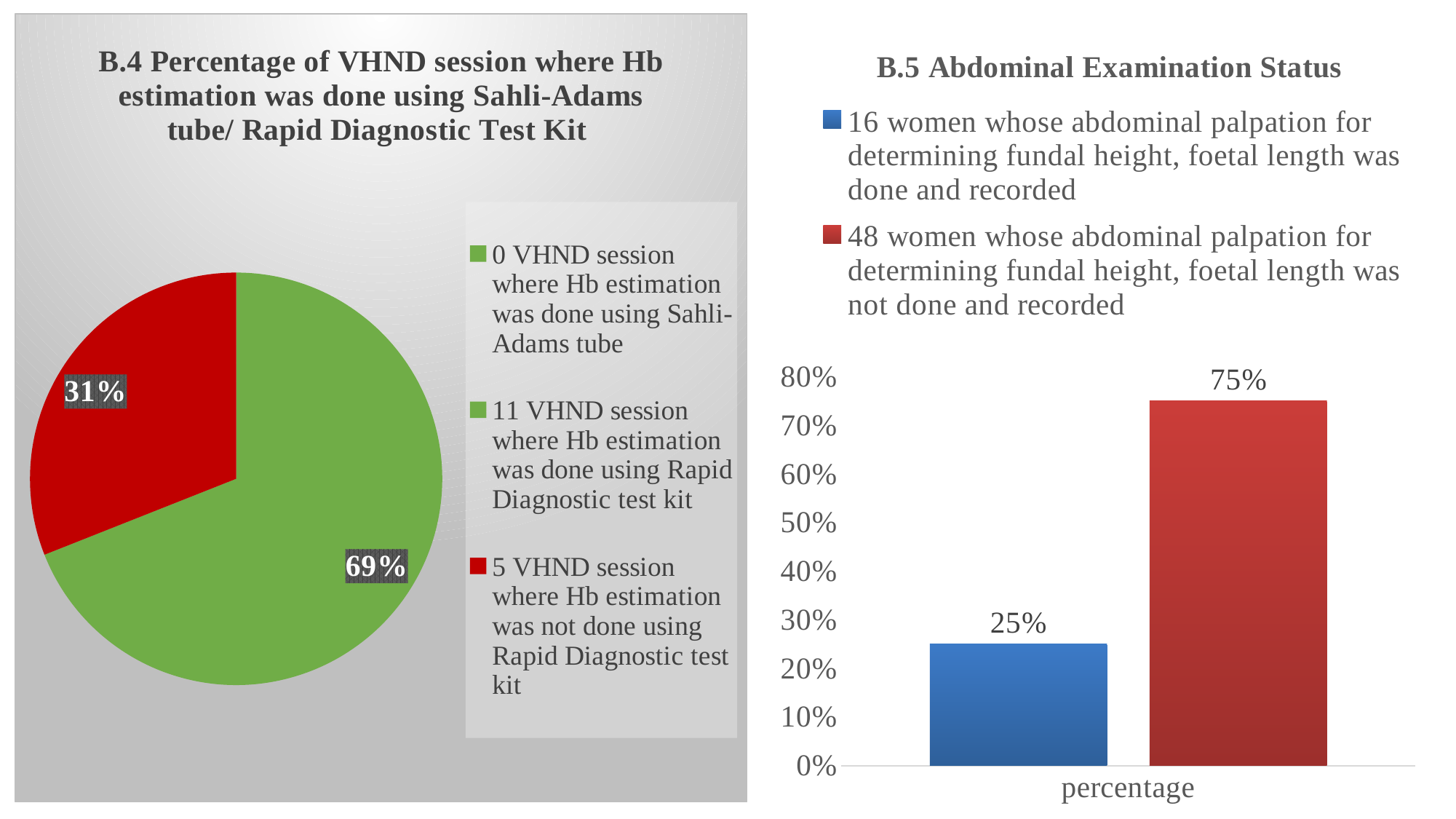
In the B.4 chart, what percentage is shown for the 5 VHND sessions where Hb estimation was not done using Rapid Diagnostic test kit? 31% In the B.5 Abdominal Examination Status chart, what percentage is shown for the 16 women whose abdominal palpation was done and recorded? 25% What kind of chart is B.5 Abdominal Examination Status? Bar chart In the B.5 chart, what is the difference between the 75% bar and the 25% bar? 50% How many entries does the legend of the B.4 chart list? 3 In the B.5 Abdominal Examination Status chart, what percentage is shown for the 48 women whose abdominal palpation was not done and recorded? 75% In the B.4 chart, what percentage is shown for the 11 VHND sessions where Hb estimation was done using Rapid Diagnostic test kit? 69% How many bars are plotted in the B.5 Abdominal Examination Status chart? 2 In the B.5 chart, which group has the higher percentage? 48 women whose abdominal palpation was not done and recorded In the B.4 chart, what is the difference between the 69% slice and the 31% slice? 38% In the B.4 chart, which colour represents the VHND sessions where Hb estimation was done using Rapid Diagnostic test kit? Green What kind of chart is B.4? Pie chart